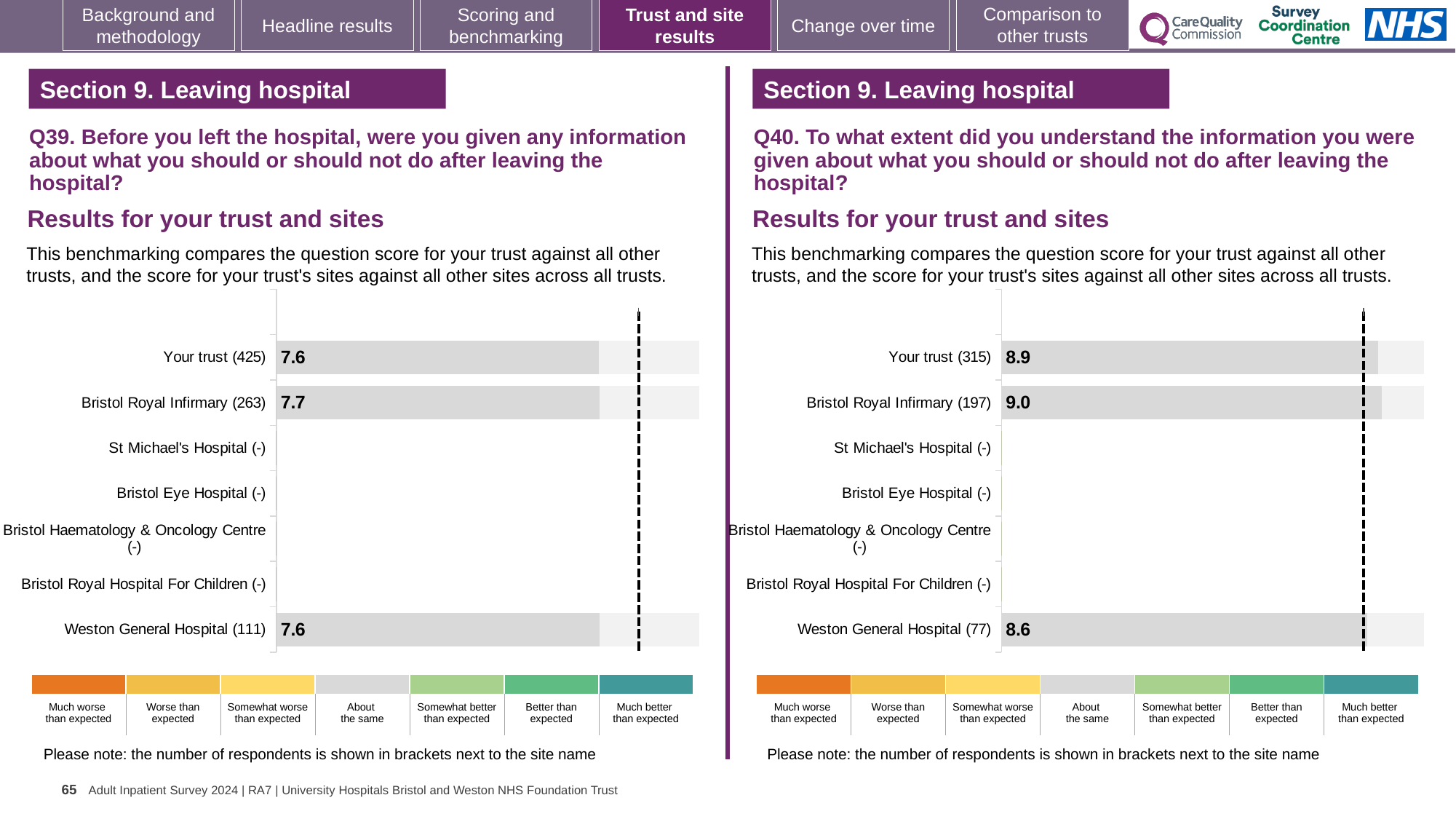
On the Q40 chart (right), which site or trust row has the lowest score? Weston General Hospital On the Q40 chart (right), what is the score for Weston General Hospital? 8.6 On the Q39 chart (left), what is the score for Bristol Royal Infirmary? 7.7 On the Q40 chart (right), what is the difference between the scores for Bristol Royal Infirmary and Weston General Hospital? 0.4 How many site or trust rows are listed on the Q39 chart (left)? 7 On the Q40 chart (right), what is the score for Bristol Royal Infirmary? 9.0 On the Q40 chart (right), which is larger: the score for Your trust or the score for Weston General Hospital? Your trust On the Q39 chart (left), what is the difference between the scores for Bristol Royal Infirmary and Your trust? 0.1 What kind of chart is used on the Q39 chart (left)? Bar chart On the Q40 chart (right), which site or trust row has the highest score? Bristol Royal Infirmary On the Q39 chart (left), what is the score for Your trust? 7.6 On the Q39 chart (left), how many respondents are shown in brackets for Weston General Hospital? 111